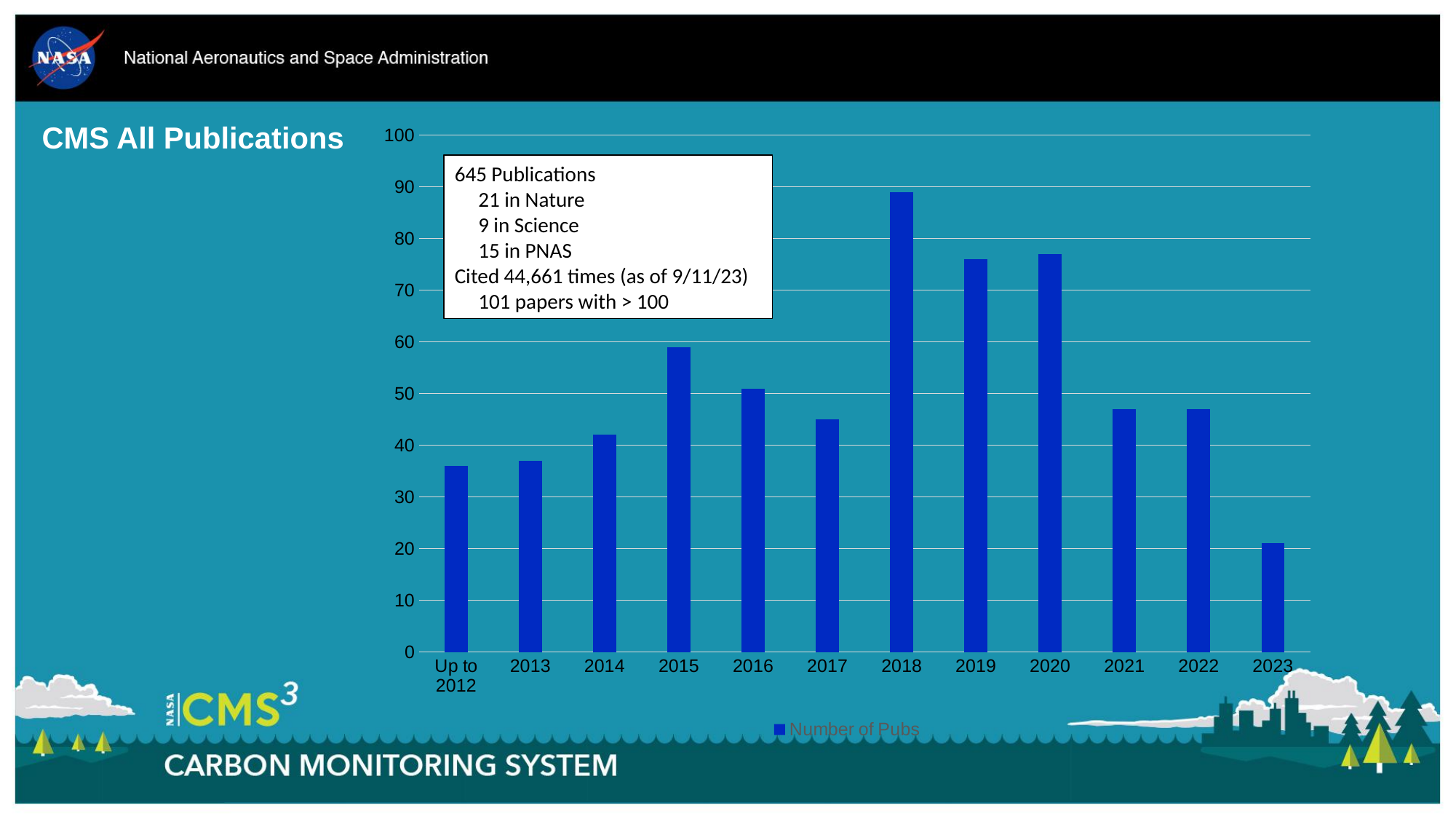
Do the values rise or fall from 2020 to 2023? fall Which has more publications, 2015 or 2016? 2015 How many categories are shown on the x axis? 12 Is the value for 2017 greater or less than 50? less Which has more publications, 2018 or 2019? 2018 Which year has the highest number of publications? 2018 How many series does the legend list? 1 Which year has the lowest number of publications? 2023 Is the value for 2019 greater or less than 70? greater Is the value for 2018 greater or less than 80? greater What kind of chart is shown on the slide? bar chart